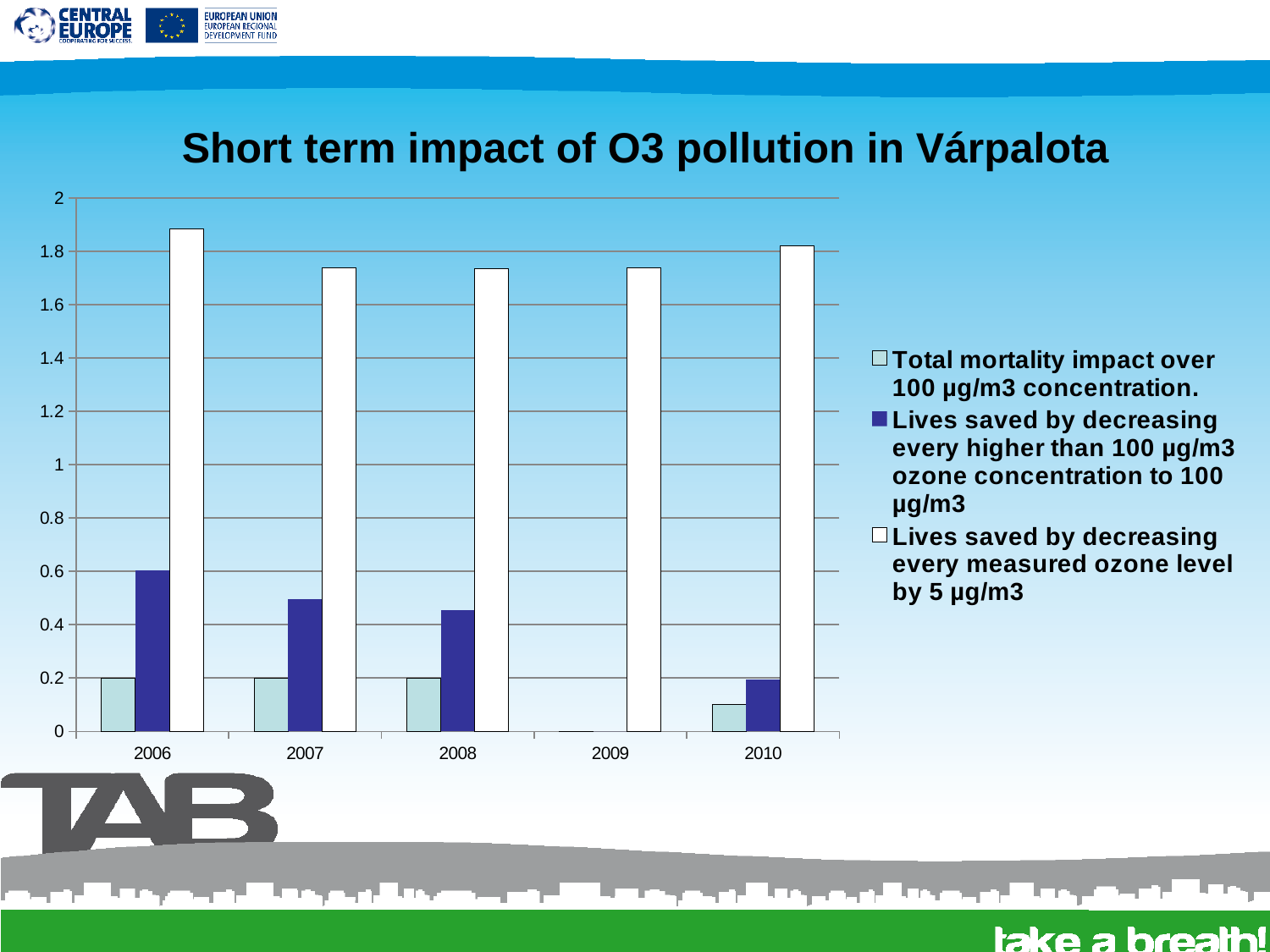
How many years are shown on the x axis of the chart? 5 How many series does the chart's legend list? 3 In which year is the value for 'Lives saved by decreasing every measured ozone level by 5 µg/m3' highest? 2006 In which year is the value for 'Lives saved by decreasing every higher than 100 µg/m3 ozone concentration to 100 µg/m3' lowest? 2009 Does the value for 'Lives saved by decreasing every higher than 100 µg/m3 ozone concentration to 100 µg/m3' rise or fall from 2006 to 2008? fall What kind of chart is shown on the slide? bar chart Is the value for 'Lives saved by decreasing every higher than 100 µg/m3 ozone concentration to 100 µg/m3' in 2006 greater or less than 0.4? greater Is the value for 'Lives saved by decreasing every measured ozone level by 5 µg/m3' in 2007 greater or less than 1.8? less Is the value for 'Lives saved by decreasing every measured ozone level by 5 µg/m3' in 2006 greater or less than 1.8? greater What is the title of the chart? Short term impact of O3 pollution in Várpalota Which year has the larger value for 'Lives saved by decreasing every higher than 100 µg/m3 ozone concentration to 100 µg/m3', 2006 or 2008? 2006